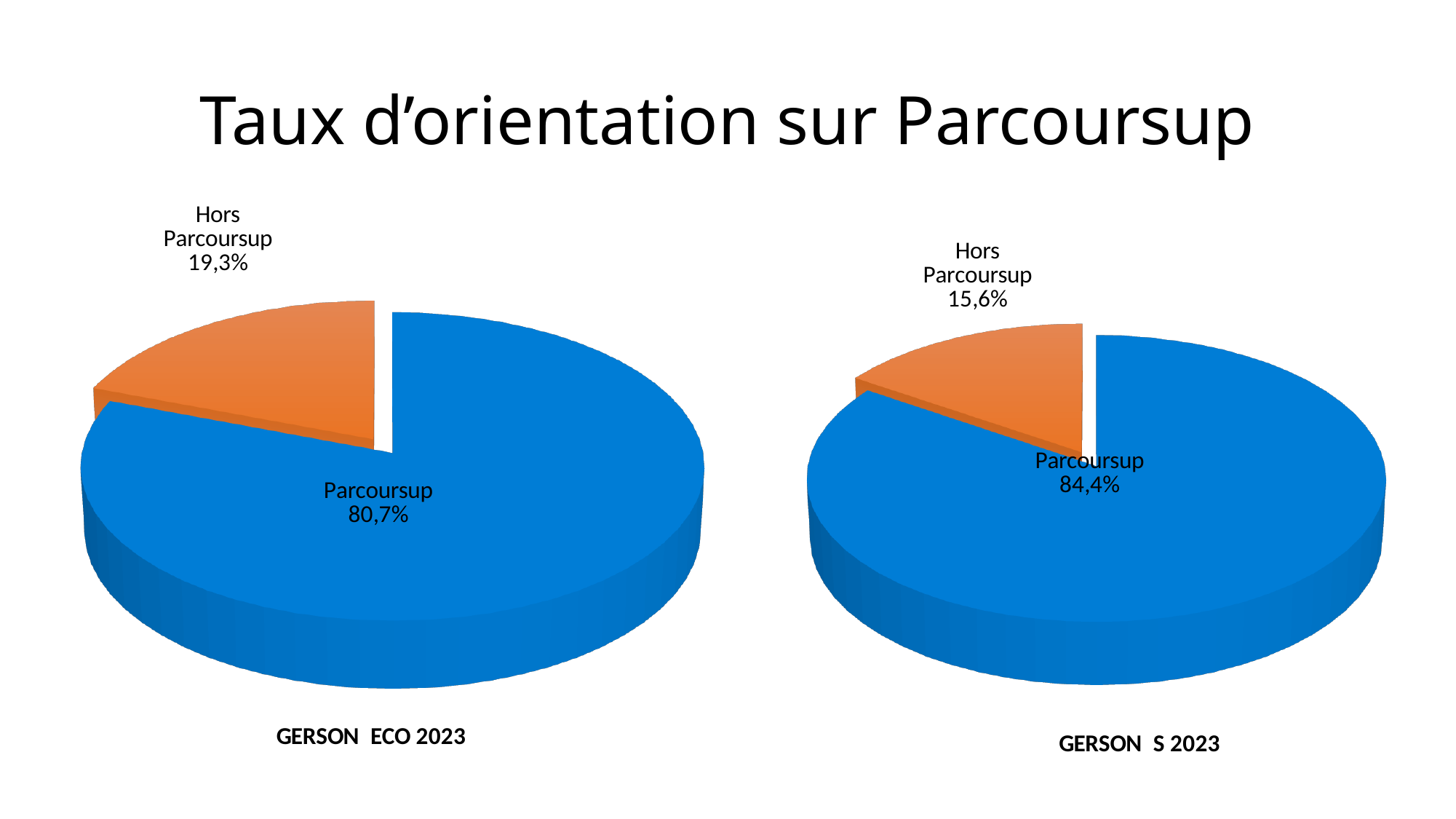
In the GERSON ECO 2023 chart, which slice is the largest? Parcoursup In the GERSON ECO 2023 chart, what is the difference between the Parcoursup and Hors Parcoursup shares? 61,4% In the GERSON S 2023 chart, which slice is the smallest? Hors Parcoursup In the GERSON ECO 2023 chart, what is the share for Hors Parcoursup? 19,3% In the GERSON S 2023 chart, what is the share for Parcoursup? 84,4% What is the difference between the Parcoursup share in the GERSON S 2023 chart and the Parcoursup share in the GERSON ECO 2023 chart? 3,7% What kind of chart is the GERSON ECO 2023 chart? Pie chart What is the title of the slide? Taux d'orientation sur Parcoursup In the GERSON S 2023 chart, what is the share for Hors Parcoursup? 15,6% Which chart has the larger Hors Parcoursup share, GERSON ECO 2023 or GERSON S 2023? GERSON ECO 2023 In the GERSON ECO 2023 chart, what is the share for Parcoursup? 80,7% How many slices does the GERSON S 2023 chart have? 2